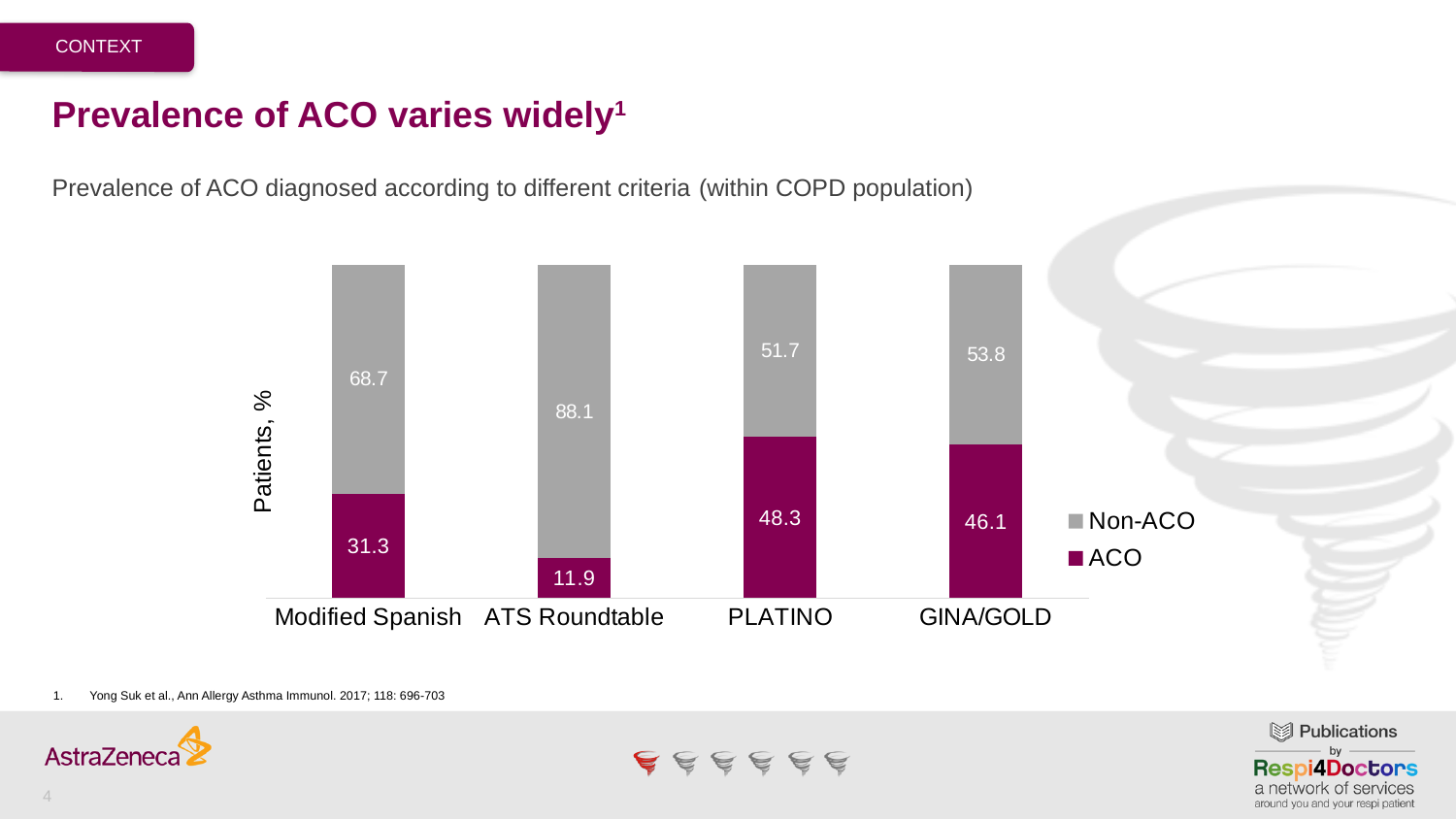
What is the difference between the Non-ACO and ACO values for Modified Spanish? 37.4 What is the ACO value for PLATINO? 48.3 Is the ACO value larger for Modified Spanish or for ATS Roundtable? Modified Spanish What is the total of the stacked bar for ATS Roundtable? 100 What is the Non-ACO value for ATS Roundtable? 88.1 What kind of chart is shown on the slide? Stacked bar chart Which criteria has the highest ACO value? PLATINO How many criteria categories are shown on the x axis? 4 What is the ACO value for Modified Spanish? 31.3 Which criteria has the lowest ACO value? ATS Roundtable How many series does the legend list? 2 What is the Non-ACO value for GINA/GOLD? 53.8